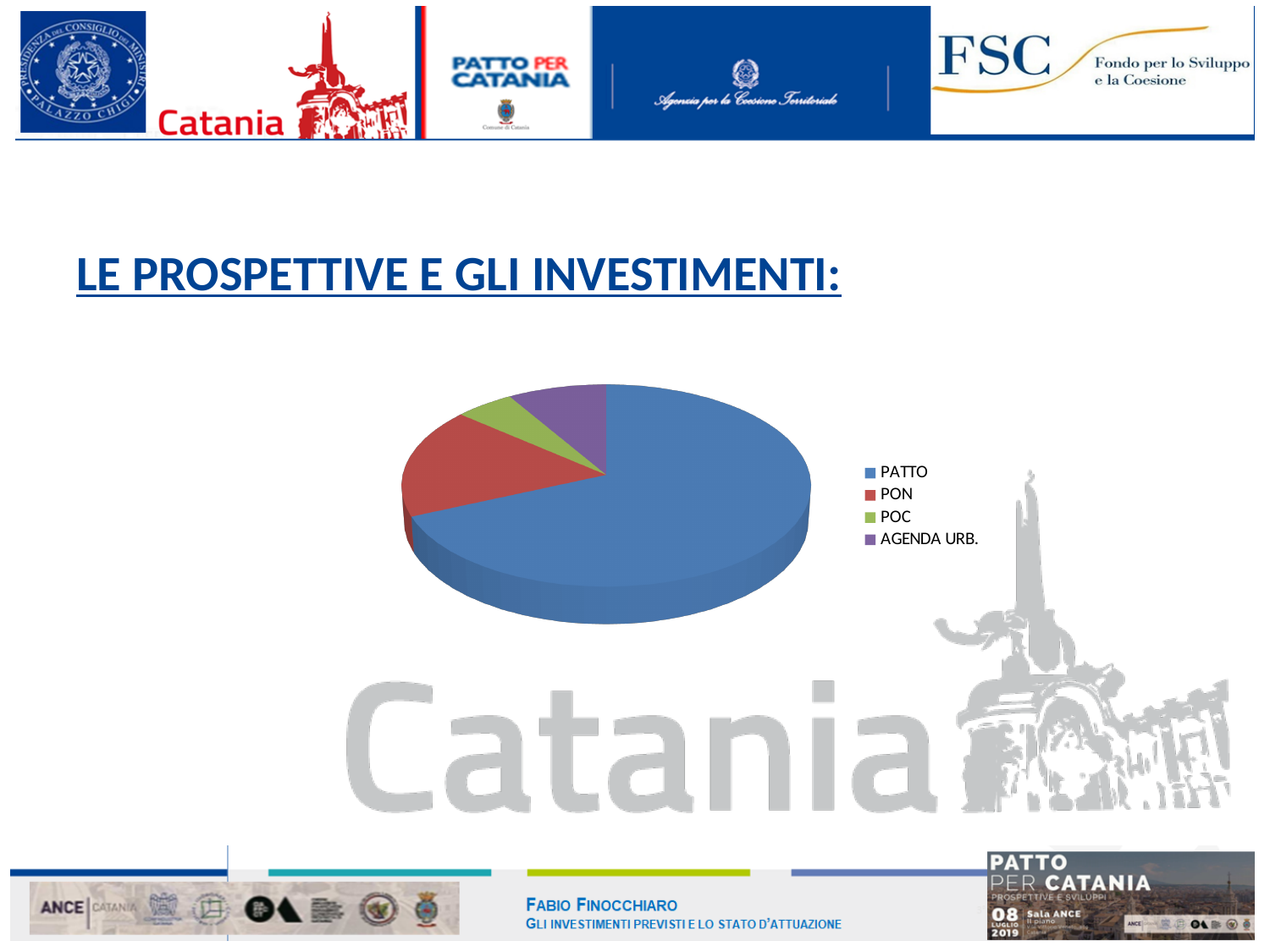
Which slice is larger in the pie chart, PATTO or PON? PATTO How many entries does the legend of the pie chart list? 4 Which legend entry is shown in red in the pie chart? PON What kind of chart is shown on the slide? pie chart Which slice is larger in the pie chart, PON or POC? PON Which slice is larger in the pie chart, PON or AGENDA URB.? PON What colour is the PATTO slice in the pie chart? blue Which category has the largest slice in the pie chart? PATTO How many slices does the pie chart have? 4